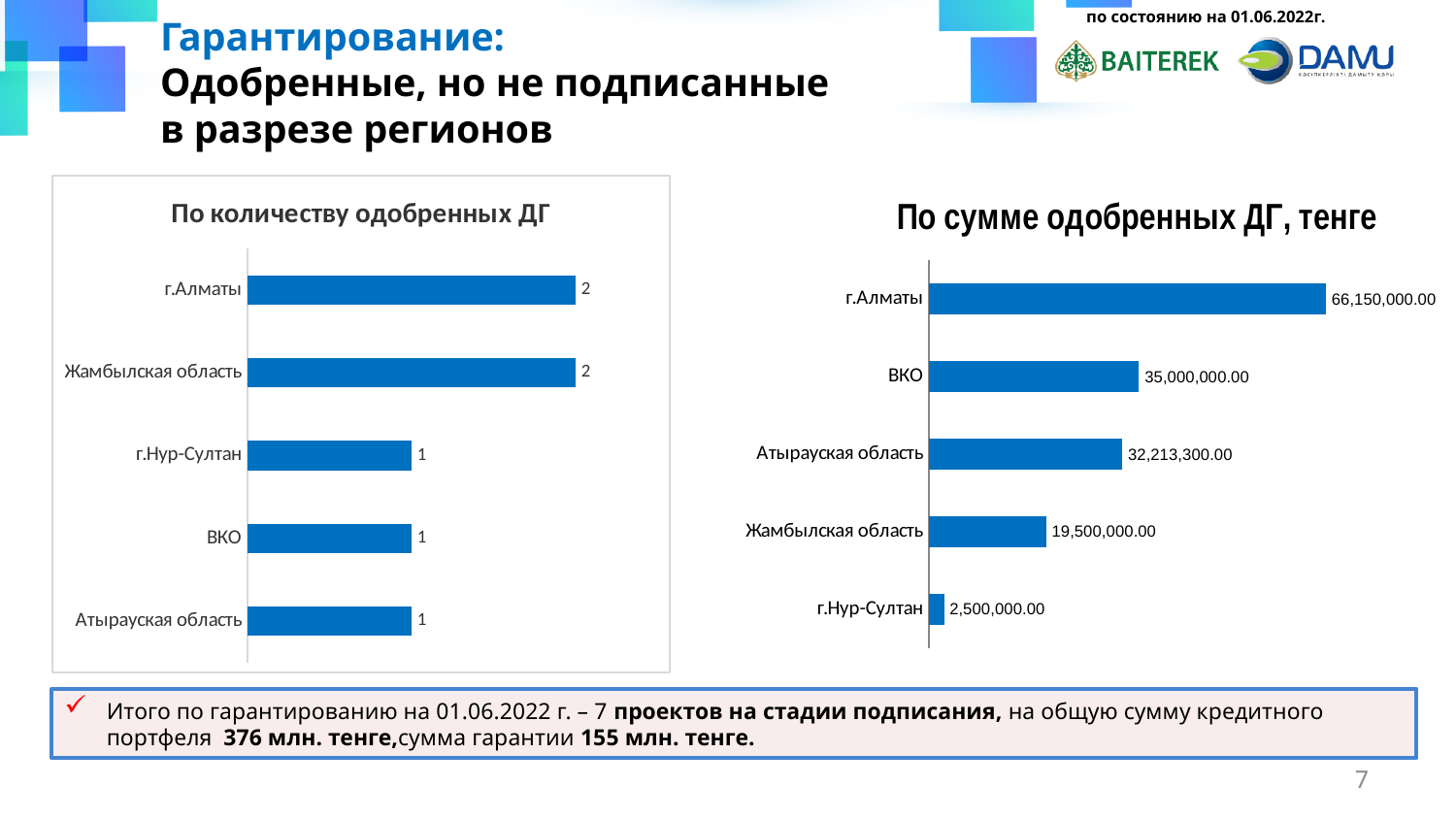
What is the title of the chart on the right side of the slide? По сумме одобренных ДГ, тенге In the chart 'По сумме одобренных ДГ, тенге', how many regions are shown? 5 In the chart 'По сумме одобренных ДГ, тенге', which is larger: Атырауская область or Жамбылская область? Атырауская область What type of chart is 'По количеству одобренных ДГ'? Bar chart In the chart 'По сумме одобренных ДГ, тенге', what is the value for ВКО? 35,000,000.00 In the chart 'По количеству одобренных ДГ', what is the value for Жамбылская область? 2 In the chart 'По сумме одобренных ДГ, тенге', what is the difference between г.Алматы and ВКО? 31,150,000.00 In the chart 'По сумме одобренных ДГ, тенге', what is the value for г.Нур-Султан? 2,500,000.00 In the chart 'По количеству одобренных ДГ', how many regions are shown? 5 In the chart 'По сумме одобренных ДГ, тенге', which region has the lowest value? г.Нур-Султан In the chart 'По сумме одобренных ДГ, тенге', which region has the highest value? г.Алматы In the chart 'По количеству одобренных ДГ', what is the value for г.Нур-Султан? 1